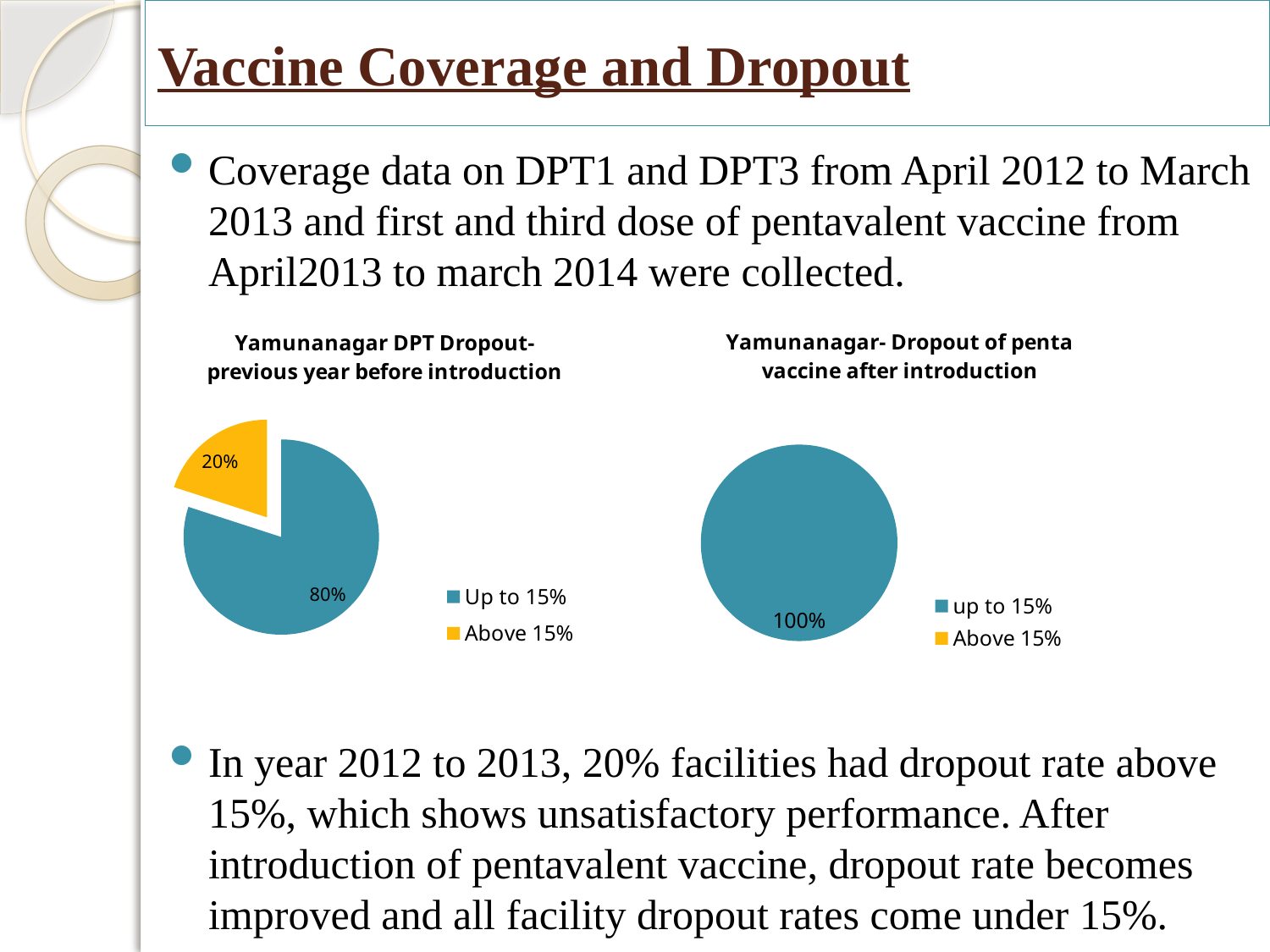
In the left chart titled 'Yamunanagar DPT Dropout- previous year before introduction', what is the difference between the 'Up to 15%' and 'Above 15%' shares? 60% How many entries does the legend of the right chart titled 'Yamunanagar- Dropout of penta vaccine after introduction' list? 2 How many pie charts are shown on the slide? 2 In the left chart titled 'Yamunanagar DPT Dropout- previous year before introduction', what colour is the 'Above 15%' slice? Yellow What type of chart is the left chart titled 'Yamunanagar DPT Dropout- previous year before introduction'? Pie chart In the right chart titled 'Yamunanagar- Dropout of penta vaccine after introduction', what share of the pie is 'up to 15%'? 100% In the left chart titled 'Yamunanagar DPT Dropout- previous year before introduction', which category has the largest slice? Up to 15% In the left chart titled 'Yamunanagar DPT Dropout- previous year before introduction', what share of the pie is 'Above 15%'? 20% In the left chart titled 'Yamunanagar DPT Dropout- previous year before introduction', what share of the pie is 'Up to 15%'? 80% In the left chart titled 'Yamunanagar DPT Dropout- previous year before introduction', which category has the smallest slice? Above 15% In the left chart titled 'Yamunanagar DPT Dropout- previous year before introduction', which is larger: 'Up to 15%' or 'Above 15%'? Up to 15% What type of chart is the right chart titled 'Yamunanagar- Dropout of penta vaccine after introduction'? Pie chart